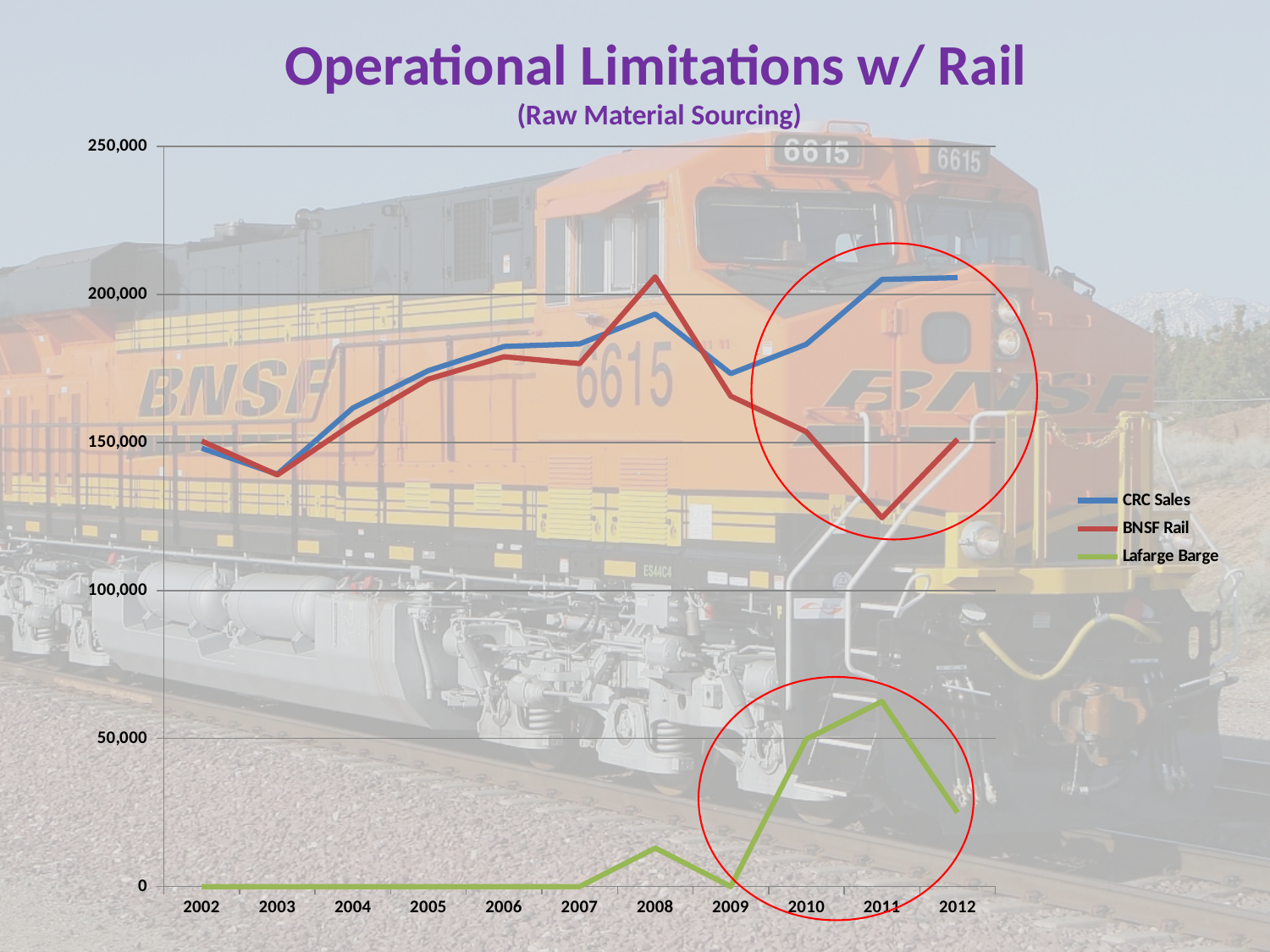
Is the BNSF Rail value for 2011 greater or less than 150,000? less Which series is drawn in green? Lafarge Barge In 2011, which is larger, CRC Sales or BNSF Rail? CRC Sales How many years are shown along the x axis? 11 How many series does the legend list? 3 In which year is the BNSF Rail value highest? 2008 In which year is the BNSF Rail value lowest? 2011 What kind of chart is shown on the slide? Line chart What is the subtitle shown under the chart title? (Raw Material Sourcing) Does the Lafarge Barge value rise or fall from 2011 to 2012? Fall Is the CRC Sales value for 2011 greater or less than 200,000? greater In which year is the Lafarge Barge value highest? 2011